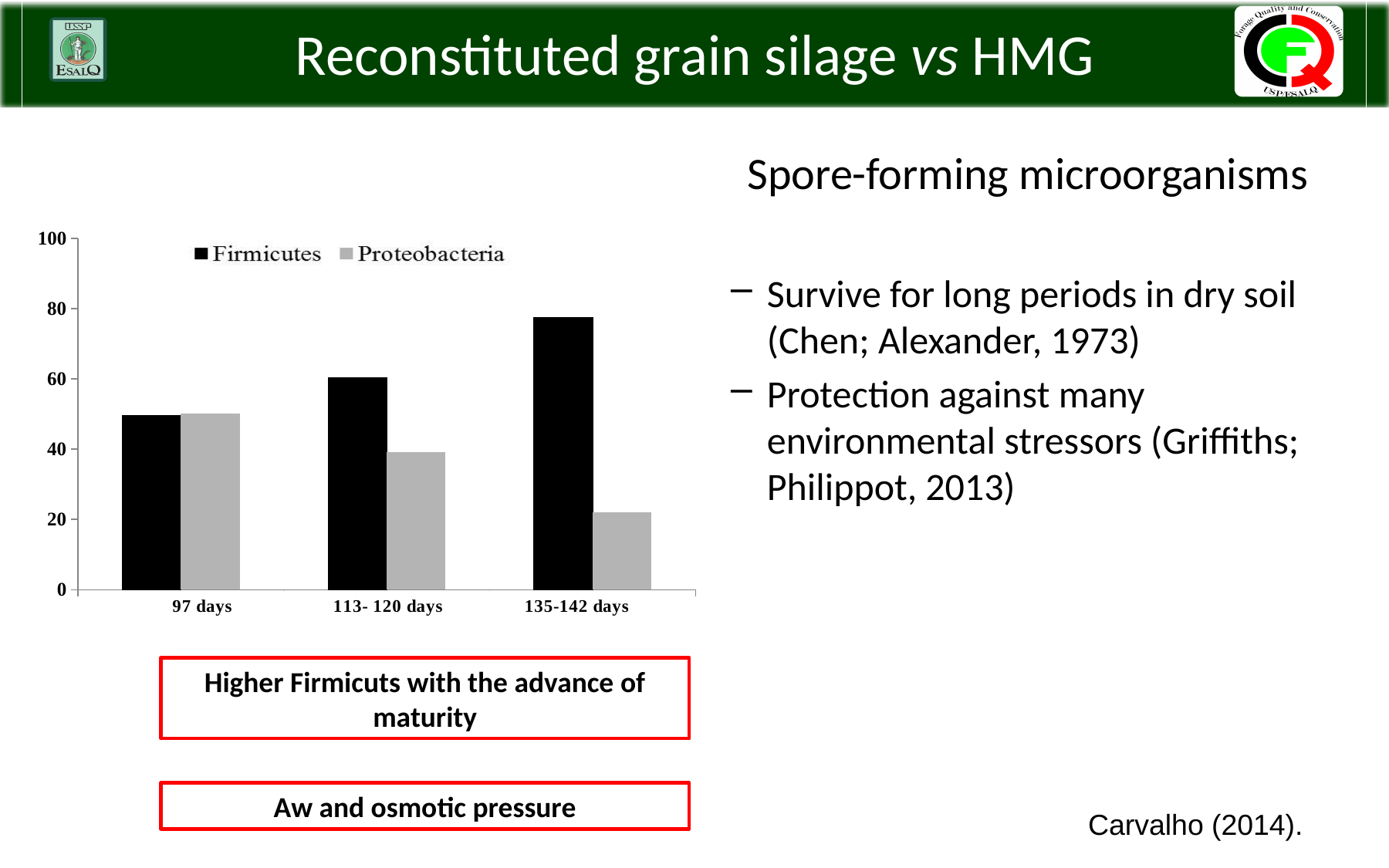
How many series does the chart legend list? 2 Which series are listed in the chart legend? Firmicutes and Proteobacteria At 135-142 days, which is larger: Firmicutes or Proteobacteria? Firmicutes At which category is the Proteobacteria value lowest? 135-142 days At 113- 120 days, which is larger: Firmicutes or Proteobacteria? Firmicutes Do the Firmicutes values rise or fall from 97 days to 135-142 days? rise How many categories are shown on the x axis of the chart? 3 What kind of chart is shown on the slide? bar chart Do the Proteobacteria values rise or fall from 97 days to 135-142 days? fall Is the Proteobacteria value at 135-142 days greater or less than 40? less Is the Firmicutes value at 135-142 days greater or less than 60? greater At which category is the Firmicutes value highest? 135-142 days